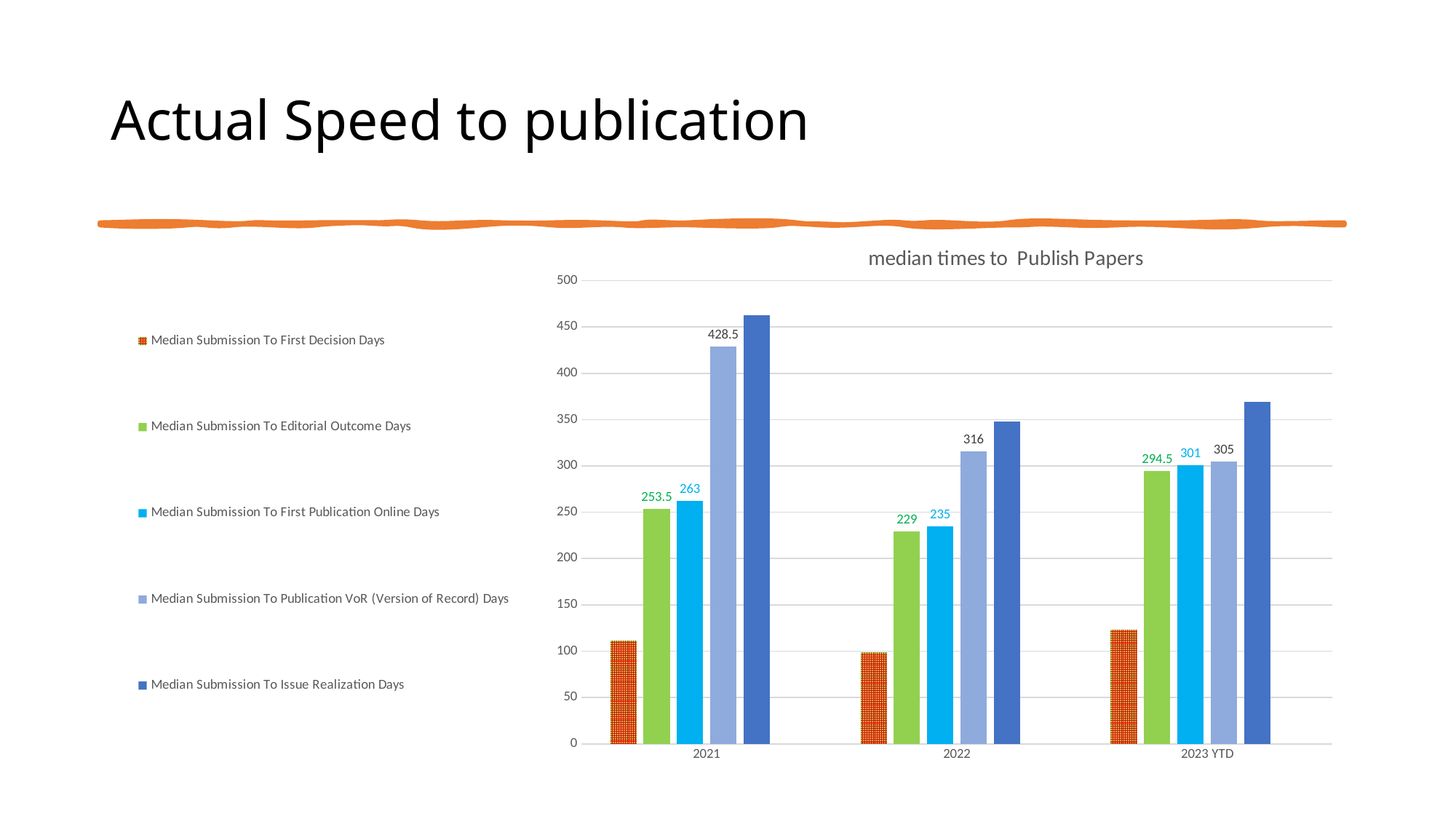
What is the Median Submission To First Publication Online Days value for 2023 YTD? 301 What is the Median Submission To Publication VoR (Version of Record) Days value for 2021? 428.5 How many series does the legend list? 5 How many year categories are shown on the x axis? 3 Is the Median Submission To First Publication Online Days value larger in 2021 or in 2022? 2021 Which year has the lowest Median Submission To Editorial Outcome Days value? 2022 Is the Median Submission To Issue Realization Days value for 2021 greater or less than 450? greater What is the difference between the Median Submission To Publication VoR (Version of Record) Days values for 2021 and 2022? 112.5 Which year has the highest Median Submission To Publication VoR (Version of Record) Days value? 2021 What type of chart is shown on the slide? Bar chart What is the Median Submission To Editorial Outcome Days value for 2022? 229